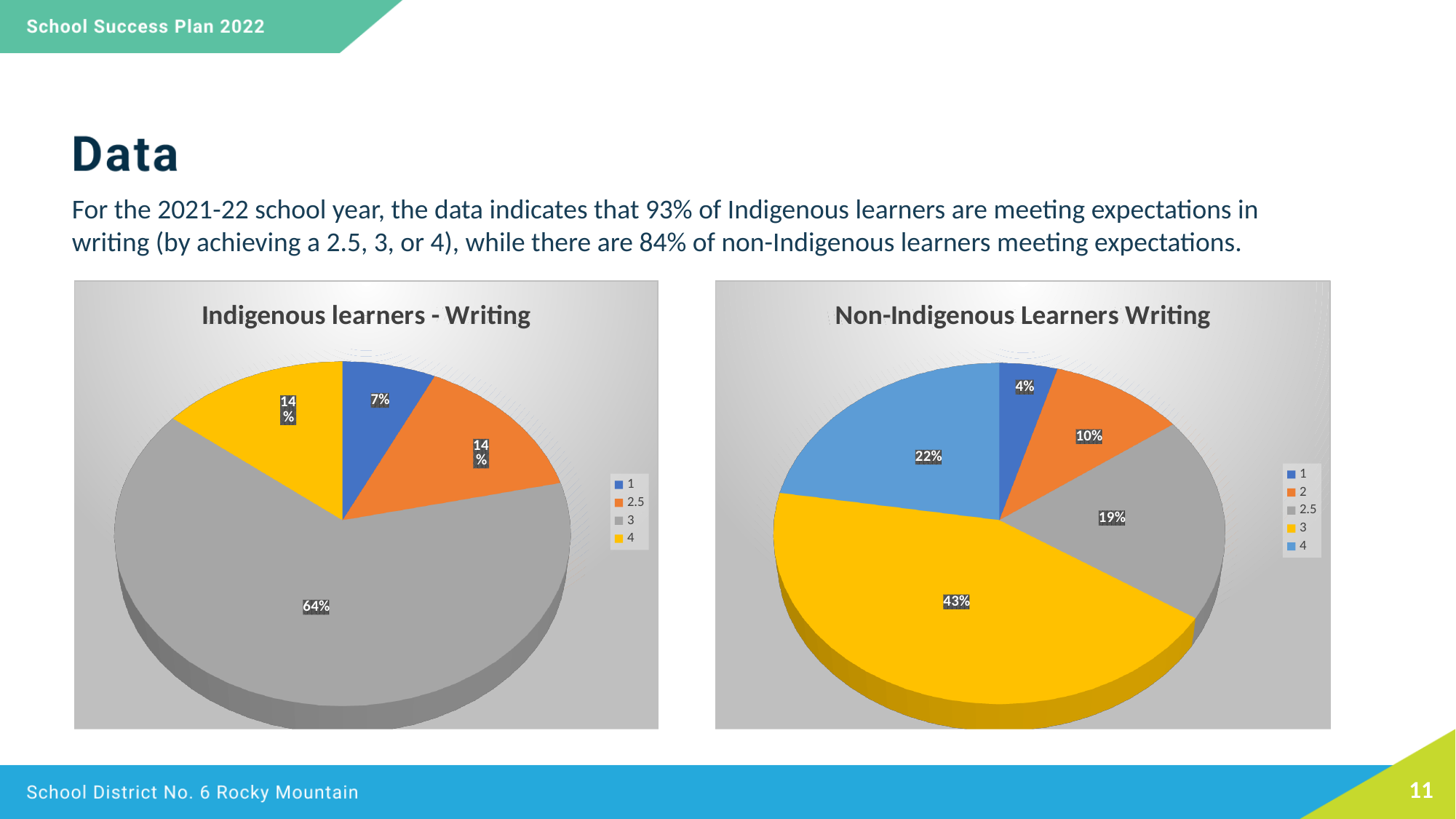
In the 'Non-Indigenous Learners Writing' chart, what share of learners achieved a 2? 10% In the 'Non-Indigenous Learners Writing' chart, what share of learners achieved a 4? 22% In the 'Indigenous learners - Writing' chart, which category has the smallest slice? 1 In the 'Indigenous learners - Writing' chart, what share of learners achieved a 3? 64% In the 'Non-Indigenous Learners Writing' chart, what is the difference between the share for 3 and the share for 2.5? 24% In the 'Indigenous learners - Writing' chart, how many categories does the legend list? 4 What type of chart is the 'Indigenous learners - Writing' chart? Pie chart In the 'Non-Indigenous Learners Writing' chart, how many categories does the legend list? 5 In the 'Non-Indigenous Learners Writing' chart, which category has the smallest slice? 1 In the 'Indigenous learners - Writing' chart, which category has the largest slice? 3